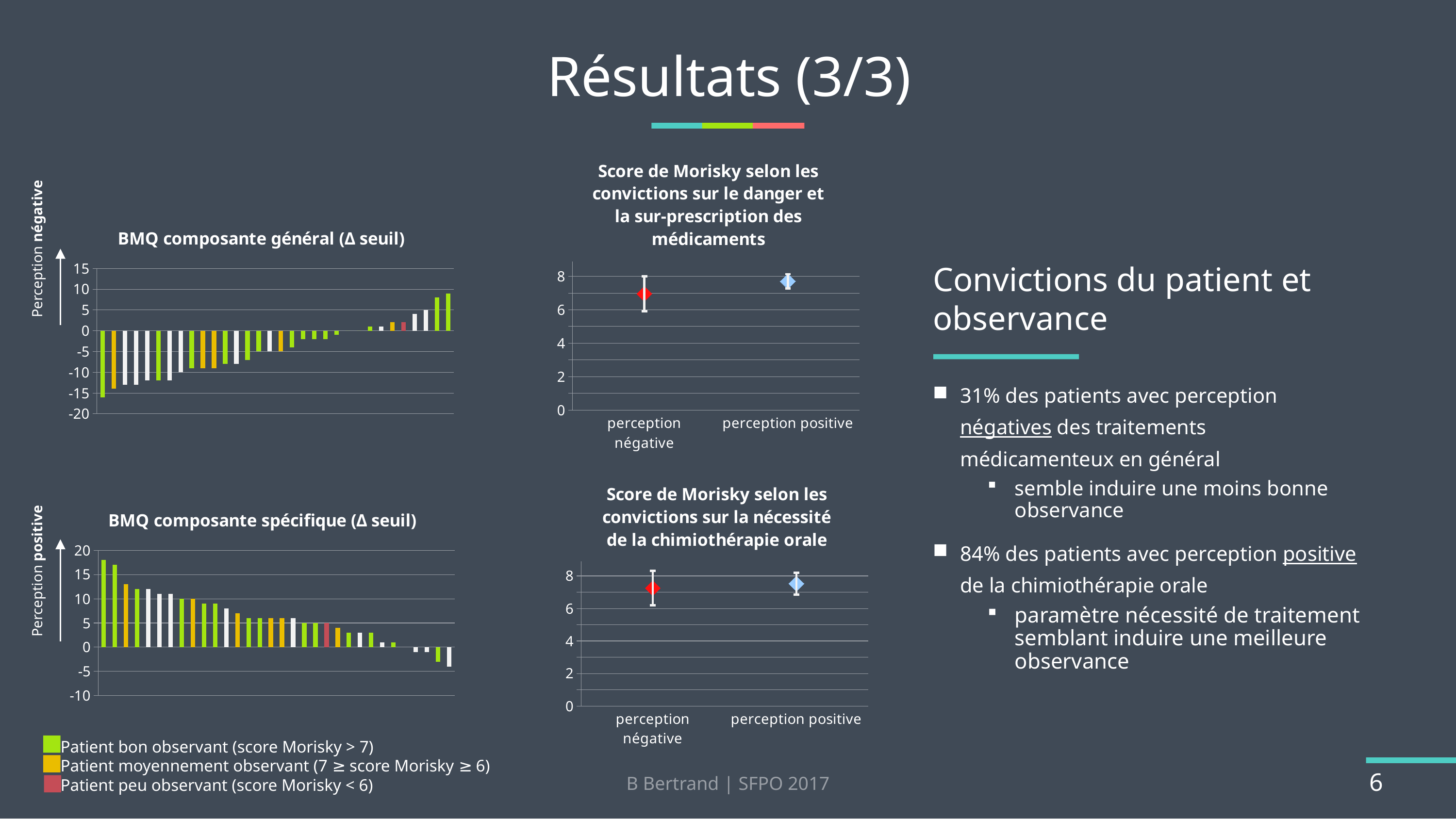
In the "BMQ composante général (Δ seuil)" chart, do the bar values rise or fall from left to right along the x axis? rise In the "BMQ composante spécifique (Δ seuil)" chart, what is the highest value shown on the y axis? 20 How many categories are shown on the x axis of the chart "Score de Morisky selon les convictions sur la nécessité de la chimiothérapie orale"? 2 According to the legend at the bottom left, which colour represents "Patient peu observant (score Morisky < 6)"? red In the chart "Score de Morisky selon les convictions sur le danger et la sur-prescription des médicaments", which category has the higher score: perception négative or perception positive? perception positive In the "BMQ composante général (Δ seuil)" chart, is the value of the rightmost bar greater or less than 5? greater What kind of chart is "BMQ composante général (Δ seuil)"? bar chart In the "BMQ composante spécifique (Δ seuil)" chart, is the value of the leftmost bar greater or less than 15? greater In the chart "Score de Morisky selon les convictions sur le danger et la sur-prescription des médicaments", is the score for perception négative greater or less than 6? greater In the "BMQ composante spécifique (Δ seuil)" chart, do the bar values rise or fall from left to right along the x axis? fall